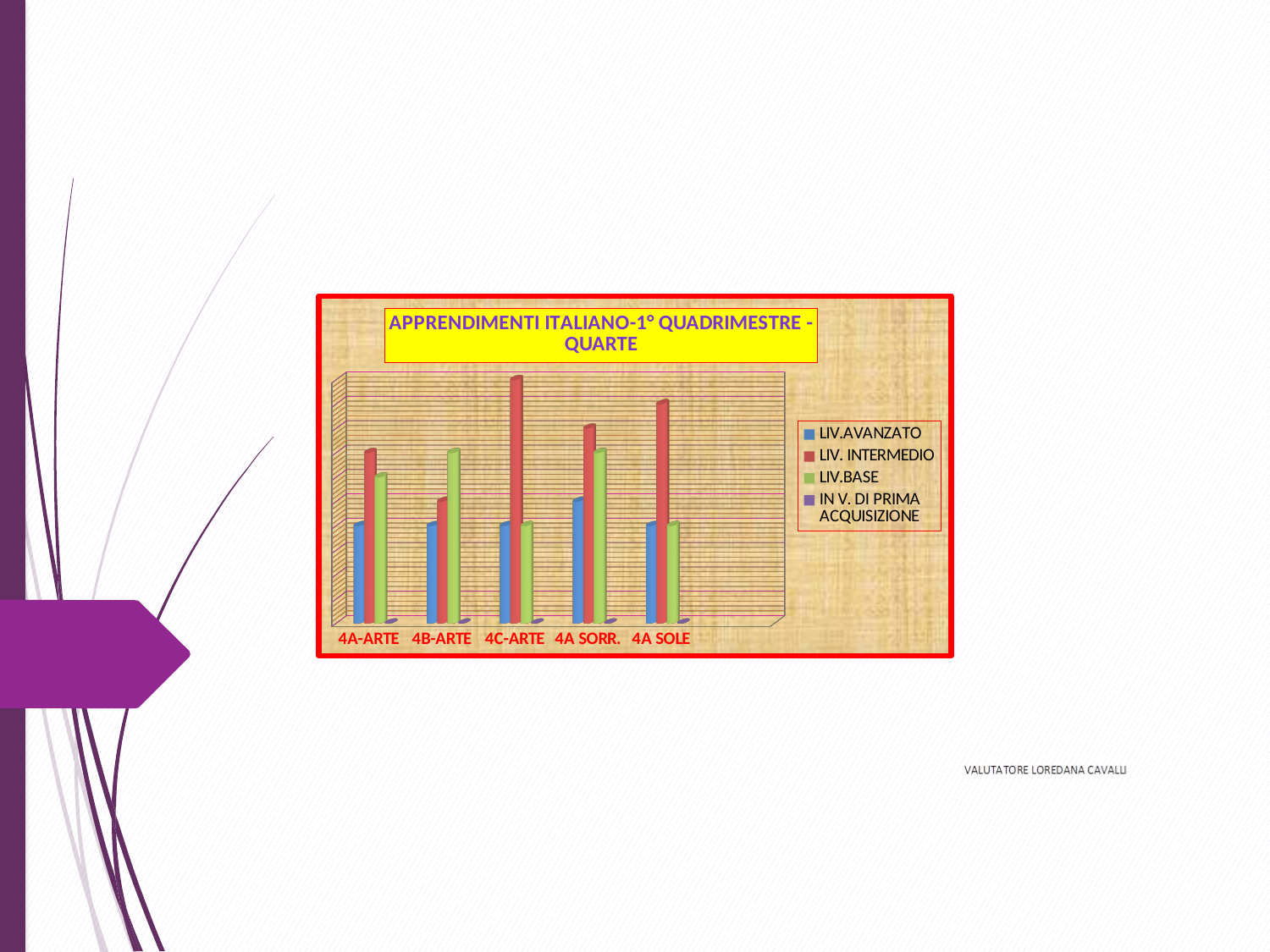
For 4C-ARTE, which is larger: LIV. INTERMEDIO or LIV.BASE? LIV. INTERMEDIO Which class has the lowest LIV. INTERMEDIO bar? 4B-ARTE Which class has the highest LIV. INTERMEDIO bar? 4C-ARTE Which series has the lowest bars across all classes? IN V. DI PRIMA ACQUISIZIONE What is the title of the chart? APPRENDIMENTI ITALIANO-1° QUADRIMESTRE - QUARTE How many classes (categories) are shown on the x axis? 5 What kind of chart is shown on the slide? bar chart Which class has the highest LIV.AVANZATO bar? 4A SORR. How many series does the legend list? 4 For 4A SOLE, which is larger: LIV. INTERMEDIO or LIV.BASE? LIV. INTERMEDIO Which series is shown in green in the legend? LIV.BASE For 4B-ARTE, which is larger: LIV.BASE or LIV. INTERMEDIO? LIV.BASE